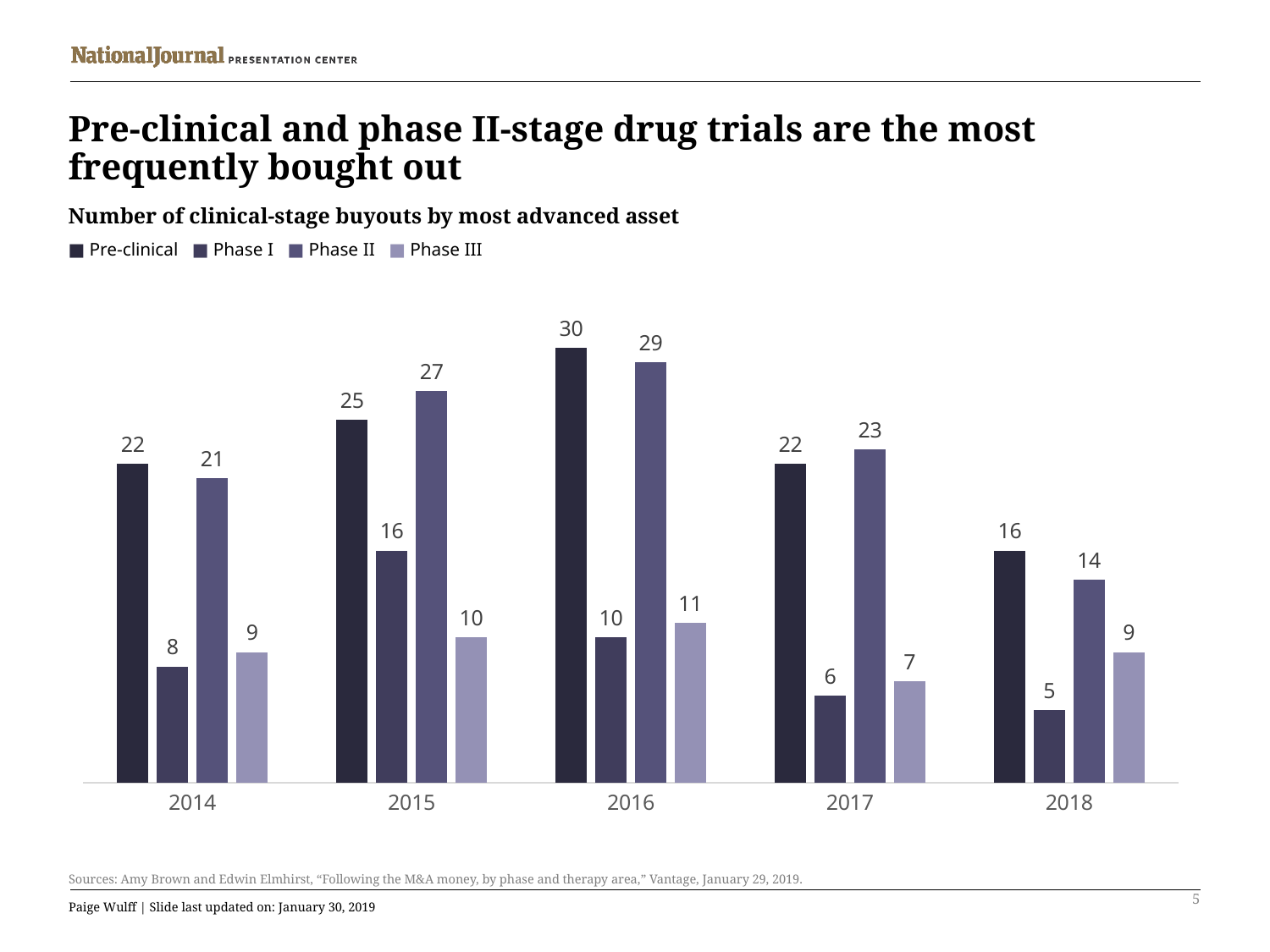
In which year were Pre-clinical buyouts lowest? 2018 What kind of chart is shown on the slide? Bar chart In which year were Phase II buyouts highest? 2016 What is the subtitle of the chart? Number of clinical-stage buyouts by most advanced asset What is the number of Phase I buyouts in 2018? 5 How many years are shown on the x axis? 5 What is the difference between Pre-clinical and Phase I buyouts in 2015? 9 What is the number of Phase III buyouts in 2017? 7 Do Phase I buyouts rise or fall from 2016 to 2018? Fall What is the number of Pre-clinical buyouts in 2016? 30 How many series does the legend list? 4 Which was larger in 2014: Pre-clinical or Phase II buyouts? Pre-clinical